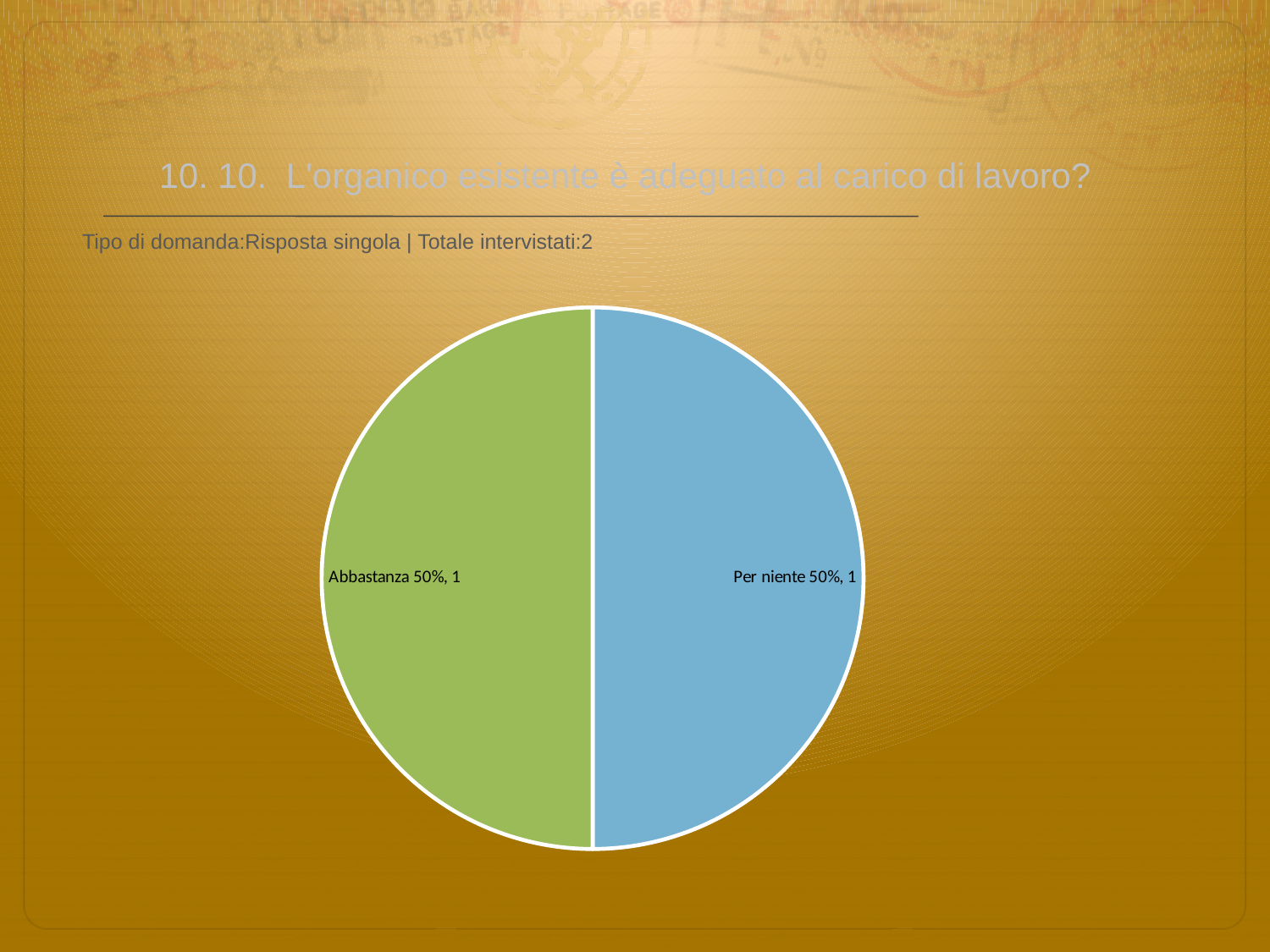
How many slices does the pie chart have? 2 What count is shown for the "Abbastanza" slice? 1 What is the total of the counts shown for the two slices of the pie chart? 2 What colour is the "Abbastanza" slice of the pie chart? green What kind of chart is shown on the slide? pie chart What count is shown for the "Per niente" slice? 1 What share of the pie does the "Abbastanza" slice represent? 50% What is the difference between the percentages shown for "Abbastanza" and "Per niente"? 0% What colour is the "Per niente" slice of the pie chart? blue What share of the pie does the "Per niente" slice represent? 50%